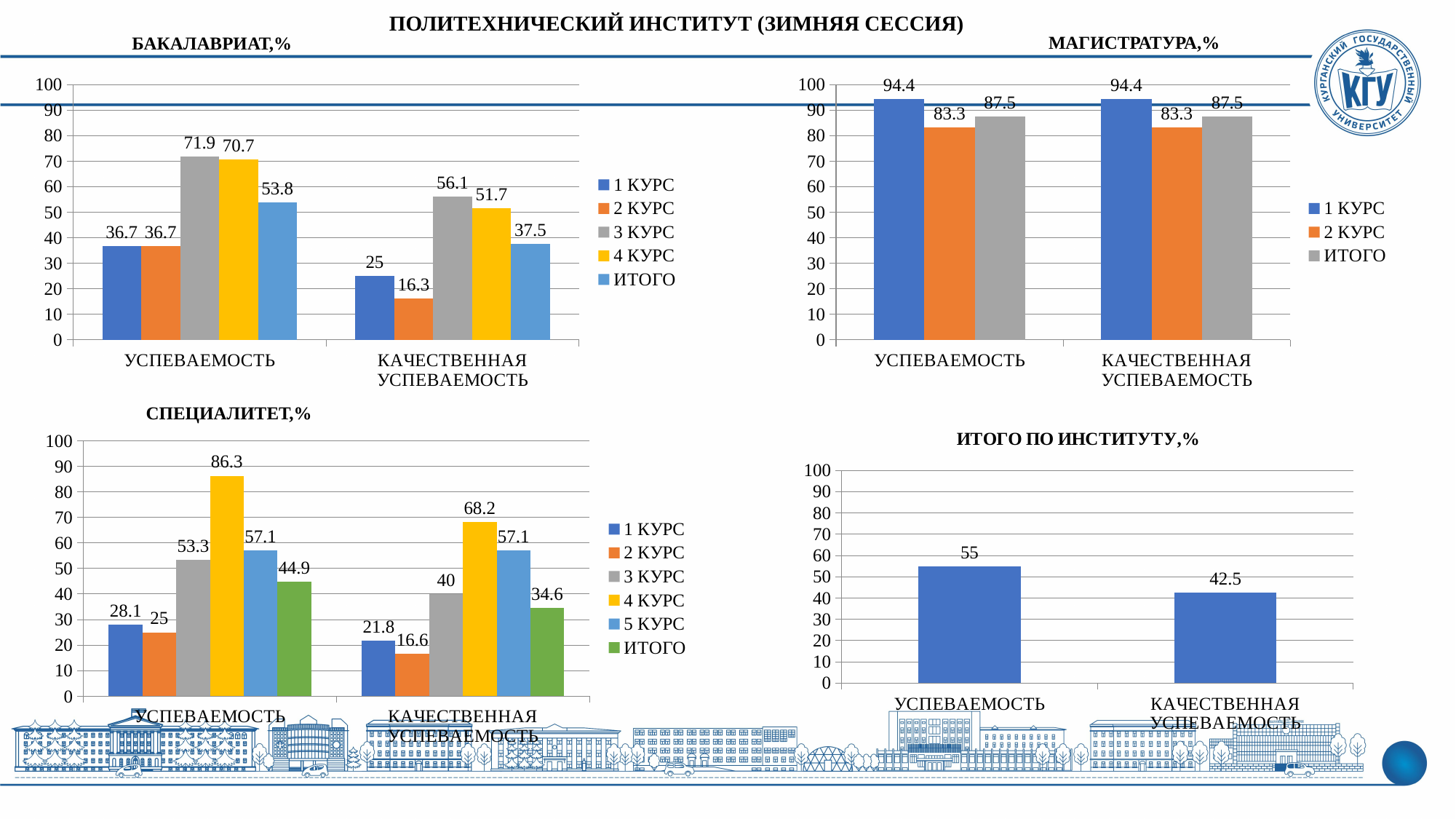
In the СПЕЦИАЛИТЕТ,% chart, what is the value for ИТОГО in the КАЧЕСТВЕННАЯ УСПЕВАЕМОСТЬ category? 34.6 In the МАГИСТРАТУРА,% chart, what is the difference between the 1 КУРС and ИТОГО values in the КАЧЕСТВЕННАЯ УСПЕВАЕМОСТЬ category? 6.9 In the БАКАЛАВРИАТ,% chart, which series has the lowest value in the КАЧЕСТВЕННАЯ УСПЕВАЕМОСТЬ category? 2 КУРС In the БАКАЛАВРИАТ,% chart, how many series does the legend list? 5 What kind of chart is the ИТОГО ПО ИНСТИТУТУ,% chart? Bar chart In the БАКАЛАВРИАТ,% chart, what is the value for 3 КУРС in the УСПЕВАЕМОСТЬ category? 71.9 In the ИТОГО ПО ИНСТИТУТУ,% chart, what is the value for КАЧЕСТВЕННАЯ УСПЕВАЕМОСТЬ? 42.5 In the СПЕЦИАЛИТЕТ,% chart, which is larger: 3 КУРС in УСПЕВАЕМОСТЬ or 3 КУРС in КАЧЕСТВЕННАЯ УСПЕВАЕМОСТЬ? 3 КУРС in УСПЕВАЕМОСТЬ In the СПЕЦИАЛИТЕТ,% chart, how many series does the legend list? 6 In the СПЕЦИАЛИТЕТ,% chart, which series has the highest value in the УСПЕВАЕМОСТЬ category? 4 КУРС In the ИТОГО ПО ИНСТИТУТУ,% chart, what is the difference between УСПЕВАЕМОСТЬ and КАЧЕСТВЕННАЯ УСПЕВАЕМОСТЬ? 12.5 In the МАГИСТРАТУРА,% chart, what is the value for 2 КУРС in the УСПЕВАЕМОСТЬ category? 83.3